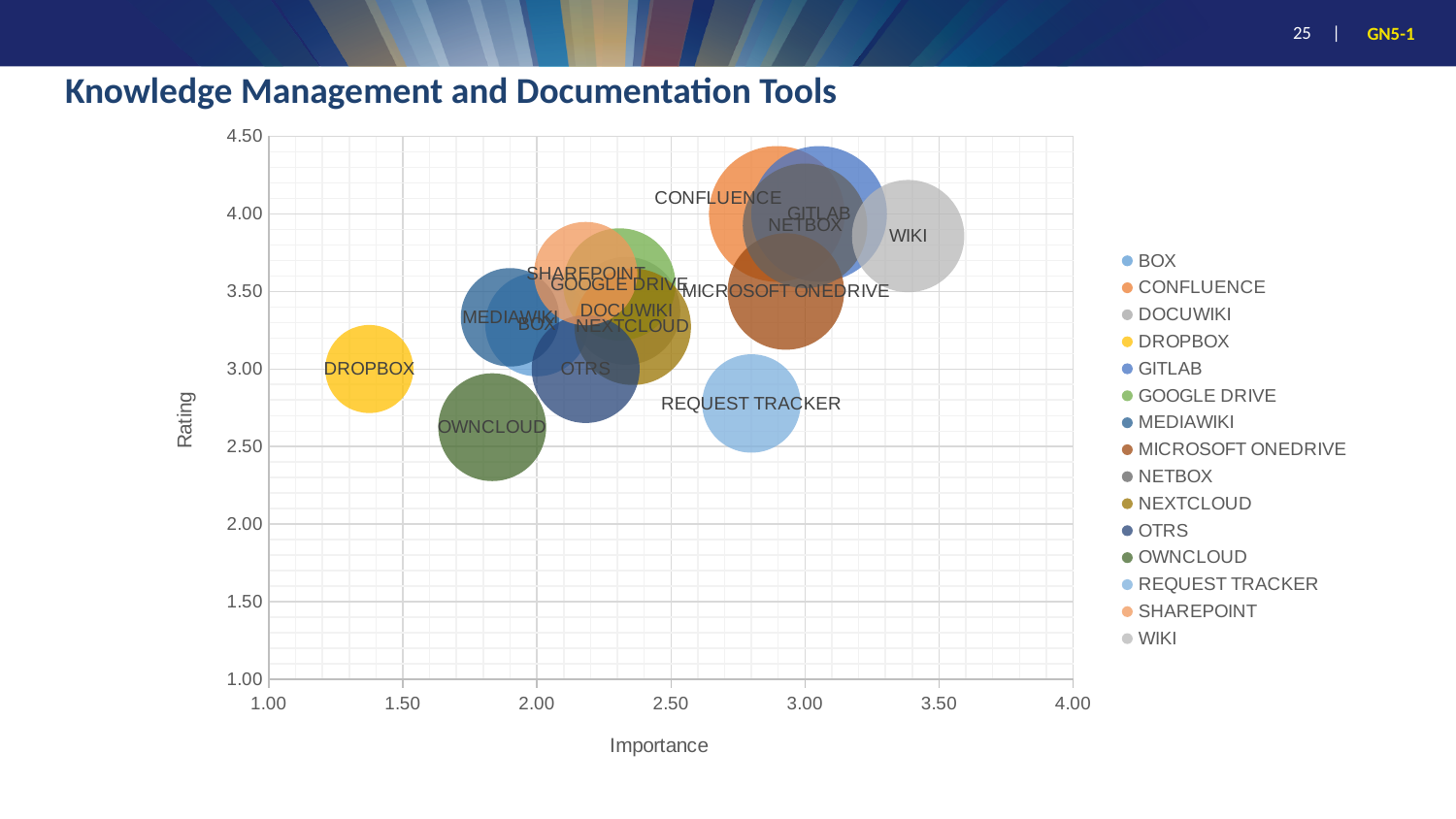
What is the label of the vertical axis? Rating Is the Rating value for OWNCLOUD greater or less than 3.00? less What kind of chart is shown on the slide? Bubble chart What is the label of the horizontal axis? Importance Is the Rating value for CONFLUENCE greater or less than 3.50? greater Which has the higher Rating, REQUEST TRACKER or CONFLUENCE? CONFLUENCE Is the Importance value for WIKI greater or less than 3.00? greater Which tool has the highest Importance value? WIKI Which tool has the lowest Importance value? DROPBOX How many tools does the legend list? 15 Which has the higher Importance, DROPBOX or WIKI? WIKI